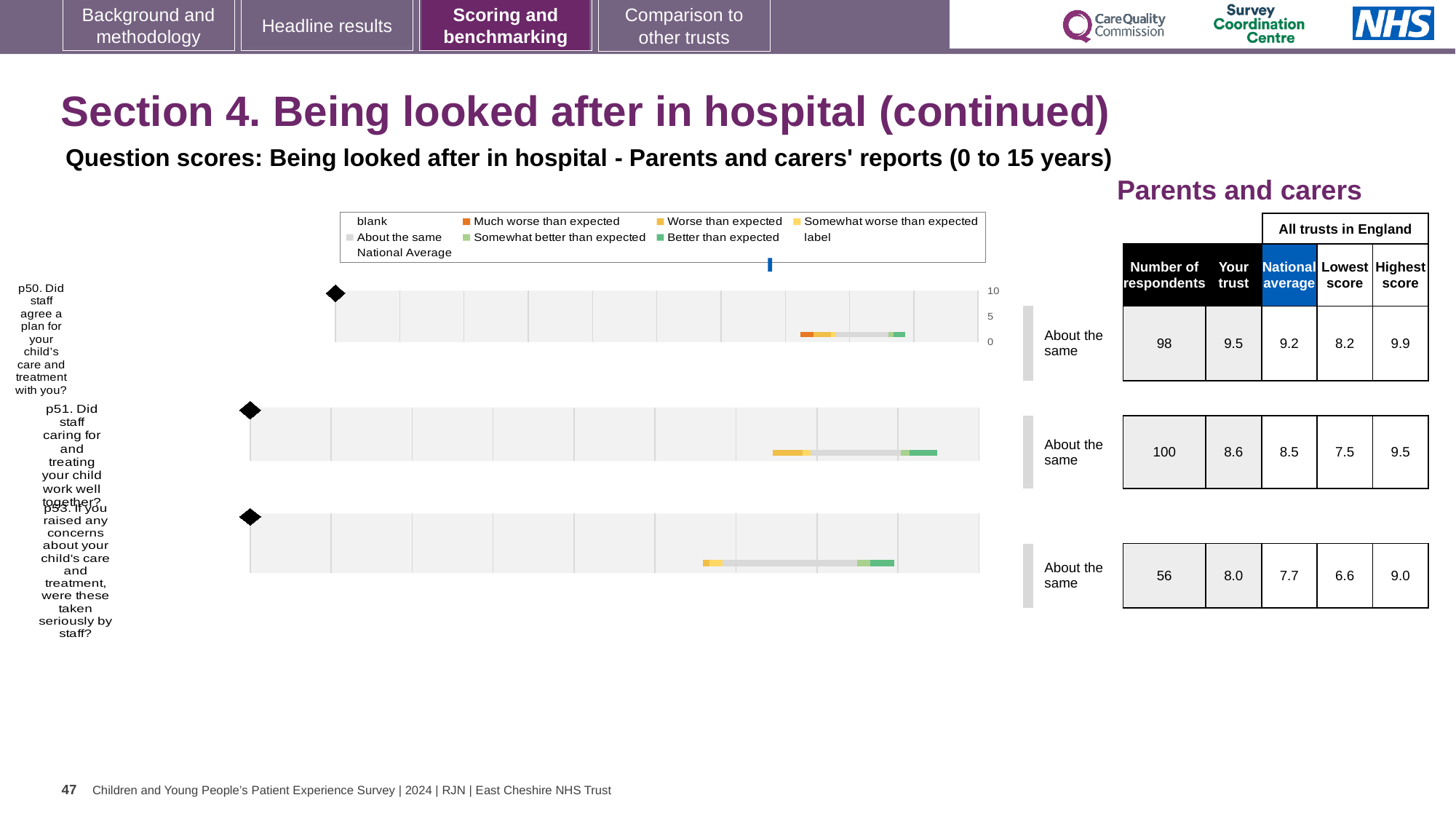
What benchmark category is shown for question p51? About the same Is the 'Your trust' score higher for question p50 or for question p53? p50 How many respondents answered question p50 (Did staff agree a plan for your child's care and treatment with you?)? 98 In the chart legend, what colour represents 'Much worse than expected'? Orange What is the national average score for question p53 (If you raised any concerns about your child's care and treatment, were these taken seriously by staff?)? 7.7 What is the 'Your trust' score for question p51 (Did staff caring for and treating your child work well together?)? 8.6 How many survey questions are charted on this slide? 3 Which of the three questions shown has the highest 'Your trust' score? p50 What is the highest score among all trusts in England for question p51? 9.5 Which of the three questions shown has the lowest number of respondents? p53 What is the lowest score among all trusts in England for question p50? 8.2 For question p50, what is the difference between the 'Your trust' score and the national average? 0.3